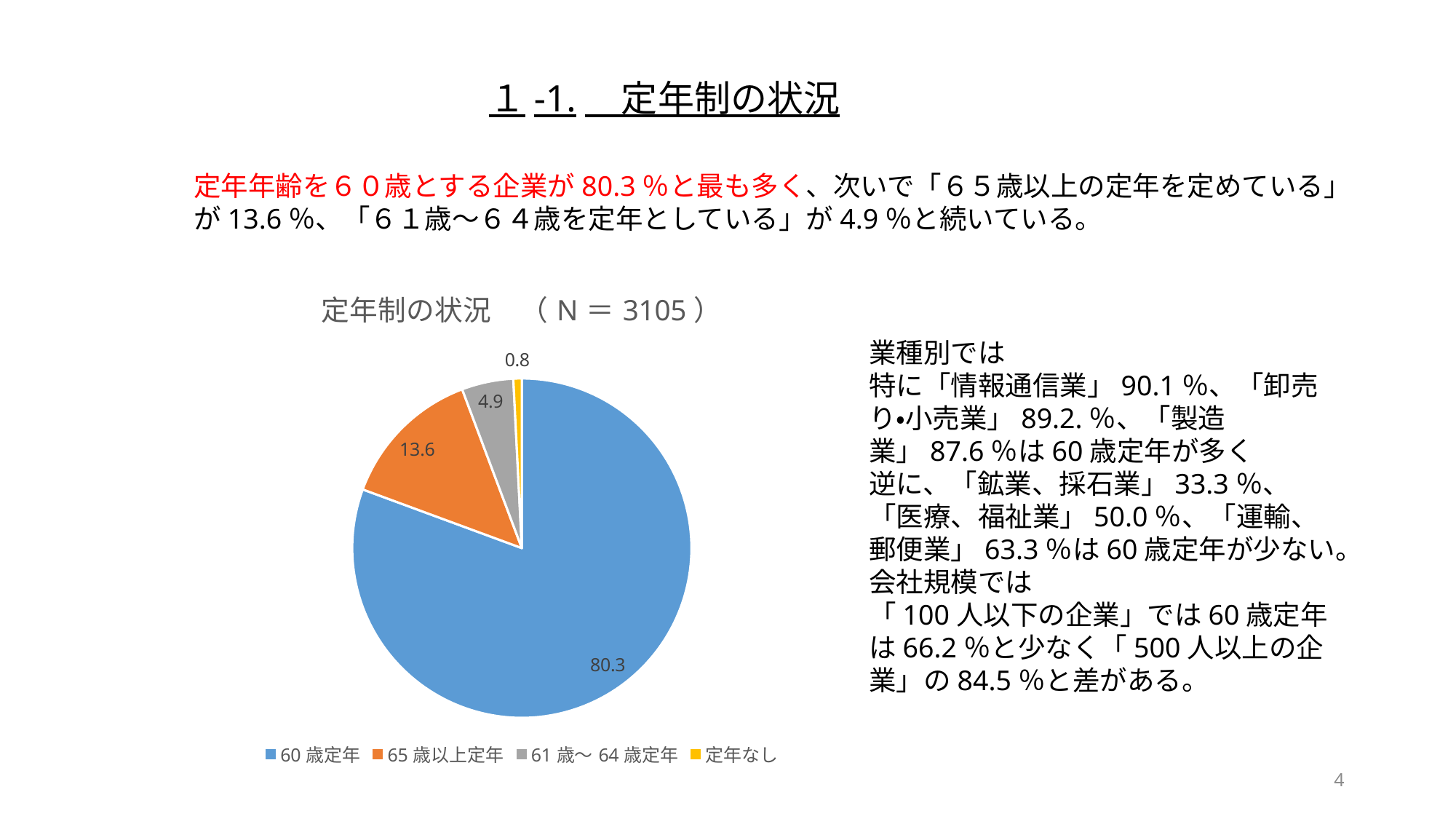
What is the N value shown in the pie chart's title? 3105 Which is larger, the value for 65歳以上定年 or the value for 61歳～64歳定年? 65歳以上定年 What is the value for 定年なし in the pie chart? 0.8 What is the value for 61歳～64歳定年 in the pie chart? 4.9 What type of chart is shown on the slide? pie chart What is the value for 65歳以上定年 in the pie chart? 13.6 How many entries does the legend of the pie chart list? 4 What is the difference between the values for 60歳定年 and 65歳以上定年? 66.7 What is the value for 60歳定年 in the pie chart? 80.3 Which category has the largest slice in the pie chart? 60歳定年 How many slices does the pie chart have? 4 Which category has the smallest slice in the pie chart? 定年なし